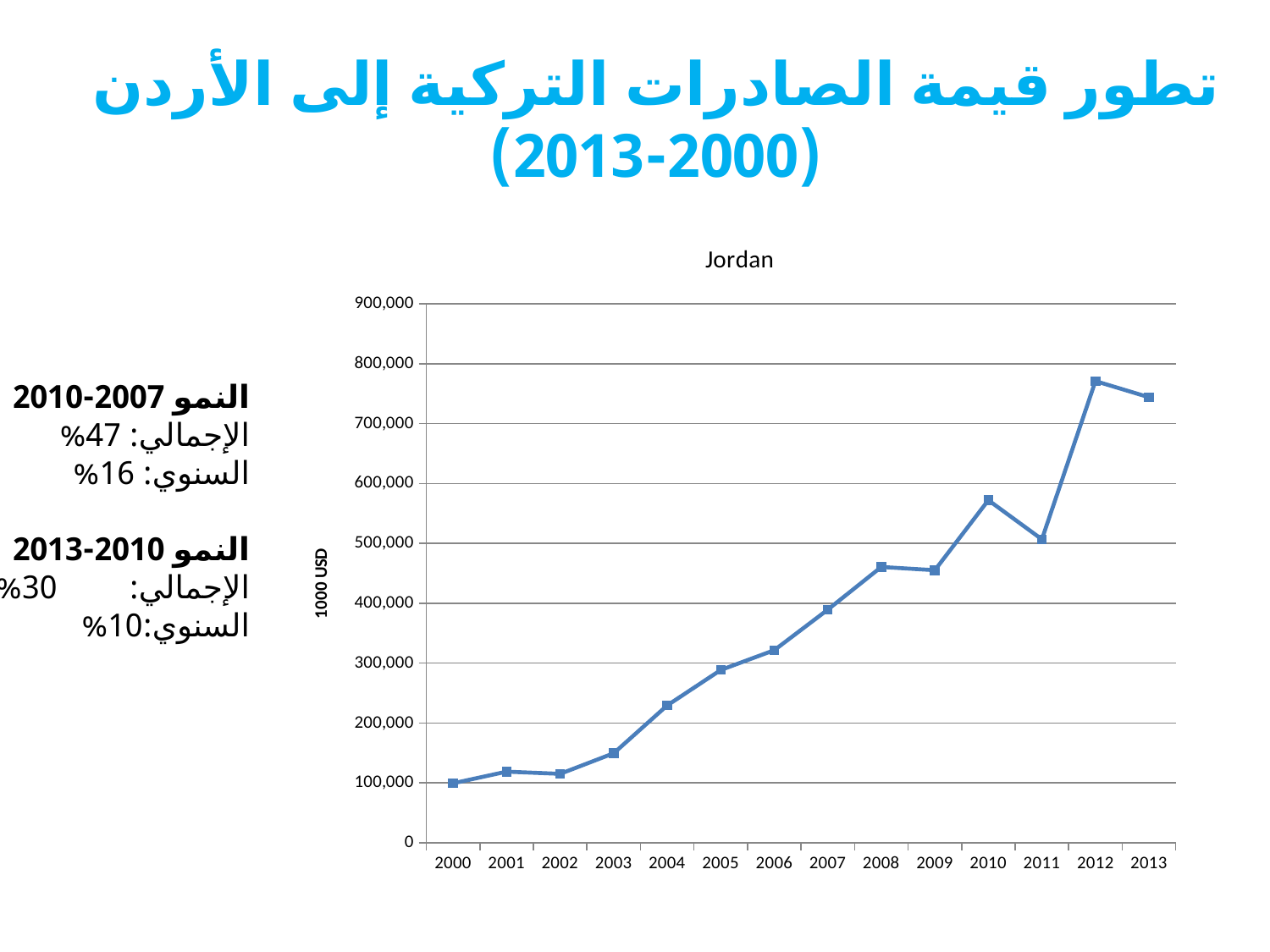
Which year has the highest value in the chart? 2012 Do the values generally rise or fall from 2000 to 2013? rise How many years are plotted on the x axis of the chart? 14 What is the label on the vertical axis of the chart? 1000 USD What kind of chart is shown on the slide? line chart Which year has the larger value, 2012 or 2013? 2012 Which year has the larger value, 2010 or 2011? 2010 What is the title of the chart? Jordan Is the value for 2012 greater or less than 800,000? less Is the value for 2004 greater or less than 200,000? greater Which year has the lowest value in the chart? 2000